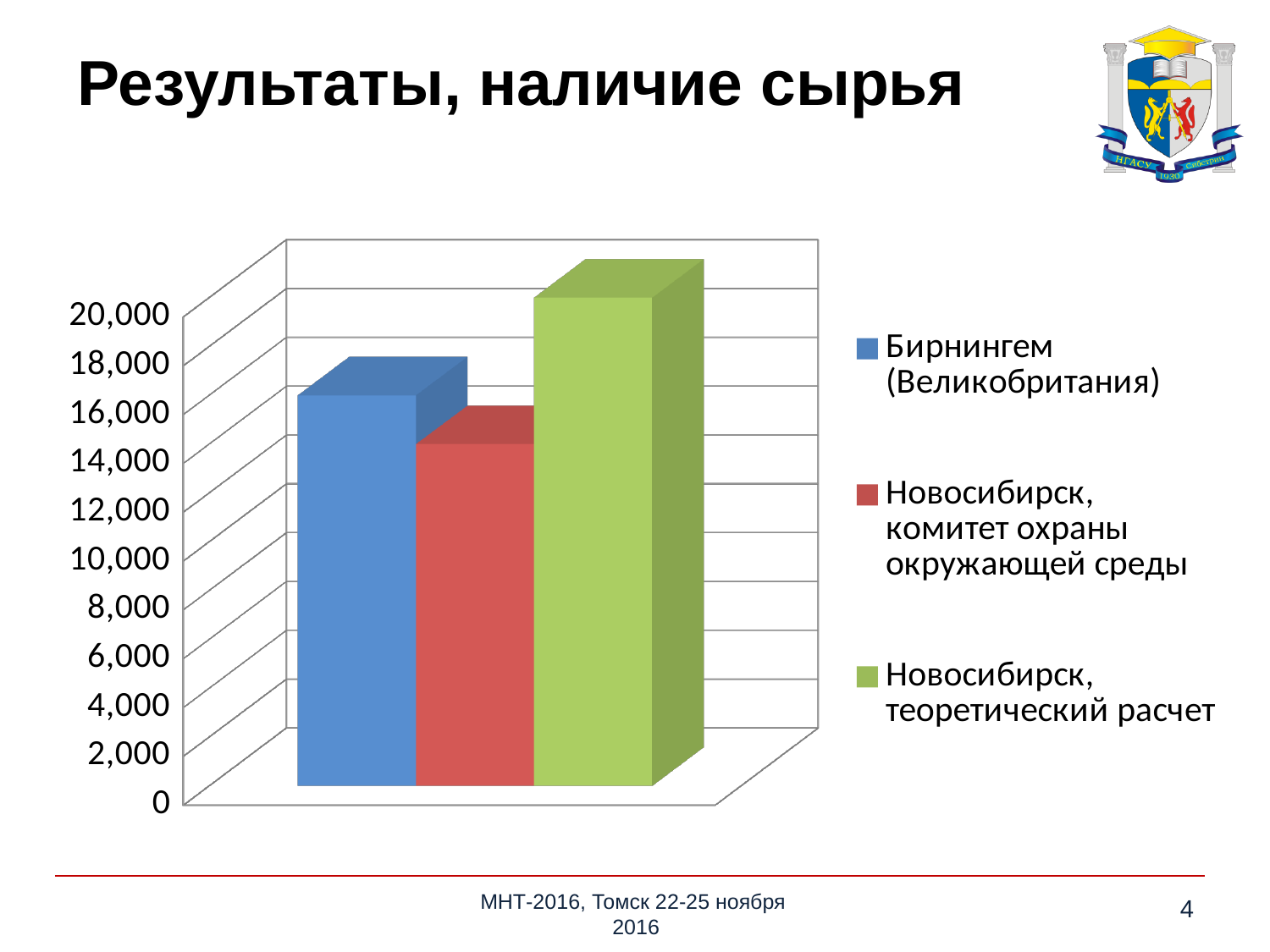
Is the value for Новосибирск, теоретический расчет greater or less than 18,000? greater Is the value for Новосибирск, комитет охраны окружающей среды greater or less than 16,000? less Which series has the lowest bar in the chart? Новосибирск, комитет охраны окружающей среды How many series does the chart legend list? 3 Is the value for Новосибирск, комитет охраны окружающей среды greater or less than 12,000? greater Which is larger: the bar for Новосибирск, теоретический расчет or the bar for Бирнингем (Великобритания)? Новосибирск, теоретический расчет Which series has the highest bar in the chart? Новосибирск, теоретический расчет What kind of chart is shown on the slide? bar chart What colour is the bar for Бирнингем (Великобритания)? blue What is the title of the slide containing the chart? Результаты, наличие сырья Which is larger: the bar for Бирнингем (Великобритания) or the bar for Новосибирск, комитет охраны окружающей среды? Бирнингем (Великобритания)